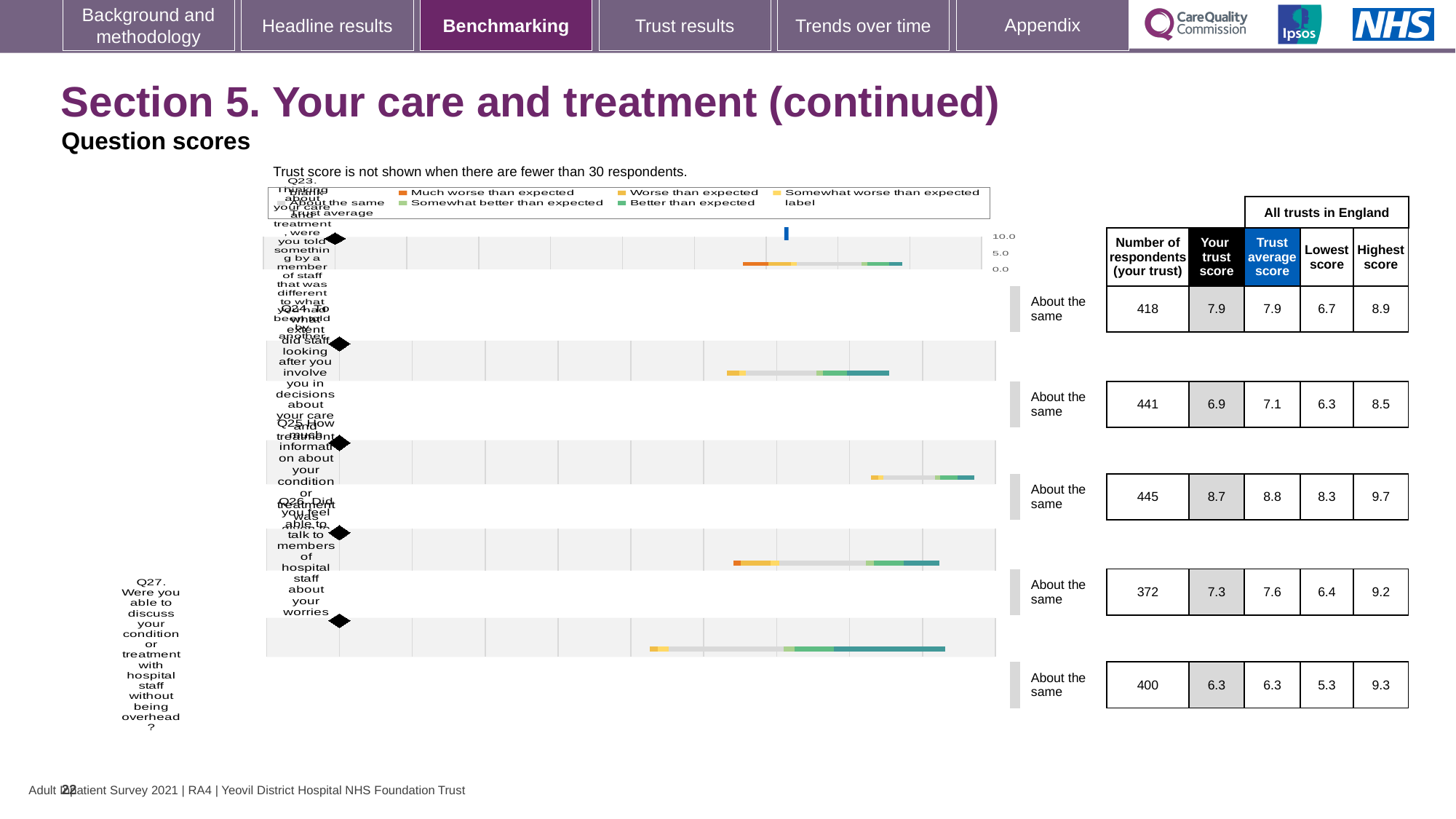
Which is larger, the highest score for Q25 or the highest score for Q27? Q25 What is the trust score for Q27 (discussing your condition or treatment without being overheard)? 6.3 How many questions (Q23 to Q27) are plotted in the chart? 5 What is the trust average score for Q24 (staff involving you in decisions about your care and treatment)? 7.1 How many respondents answered Q26 (feeling able to talk to hospital staff about your worries)? 372 What kind of chart is used to show the question scores on this slide? bar chart Which question has the lowest 'Your trust score'? Q27 Which question has the highest 'Your trust score'? Q25 What benchmark category is shown for Q23 next to the chart? About the same What is the difference between the highest score and the lowest score for Q27? 4.0 What is the maximum value shown on the chart's score axis? 10.0 What is the difference between the trust average score and your trust score for Q24? 0.2